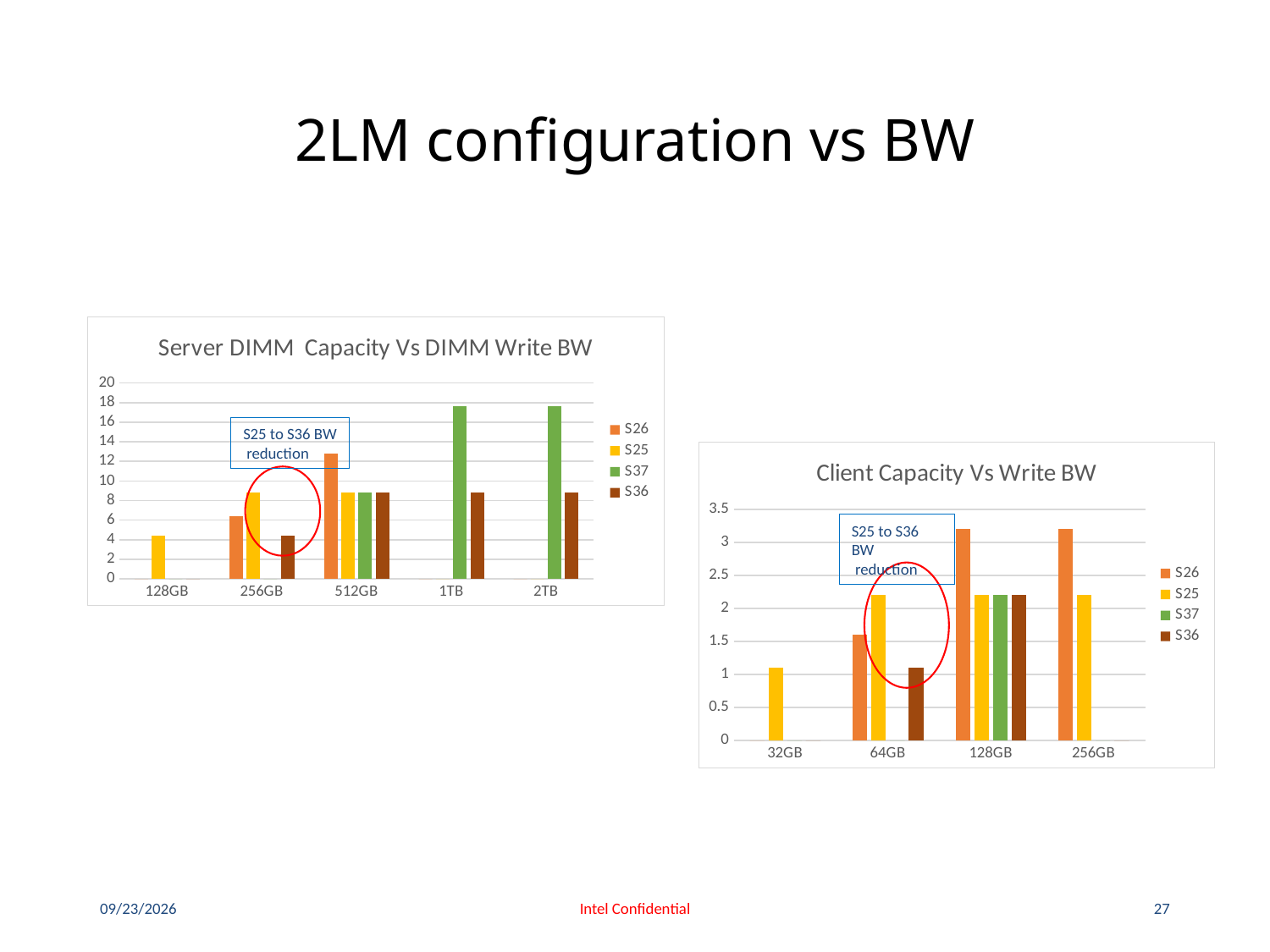
How many capacity categories are shown on the x axis of the "Client Capacity Vs Write BW" chart? 4 In the "Client Capacity Vs Write BW" chart, is the S36 value at 64GB greater or less than 1.5? less How many capacity categories are shown on the x axis of the "Server DIMM Capacity Vs DIMM Write BW" chart? 5 In the "Client Capacity Vs Write BW" chart, at 64GB, which is larger: S26 or S25? S25 In the "Client Capacity Vs Write BW" chart, is the S26 value at 128GB greater or less than 3? greater In the "Server DIMM Capacity Vs DIMM Write BW" chart, is the S37 value at 1TB greater or less than 16? greater In the "Server DIMM Capacity Vs DIMM Write BW" chart, at 256GB, which is larger: S25 or S36? S25 What kind of chart is the "Server DIMM Capacity Vs DIMM Write BW" chart? bar chart What is the title of the chart on the right side of the slide? Client Capacity Vs Write BW How many series does the legend of the "Server DIMM Capacity Vs DIMM Write BW" chart list? 4 In the "Server DIMM Capacity Vs DIMM Write BW" chart, which series has the highest value at 512GB? S26